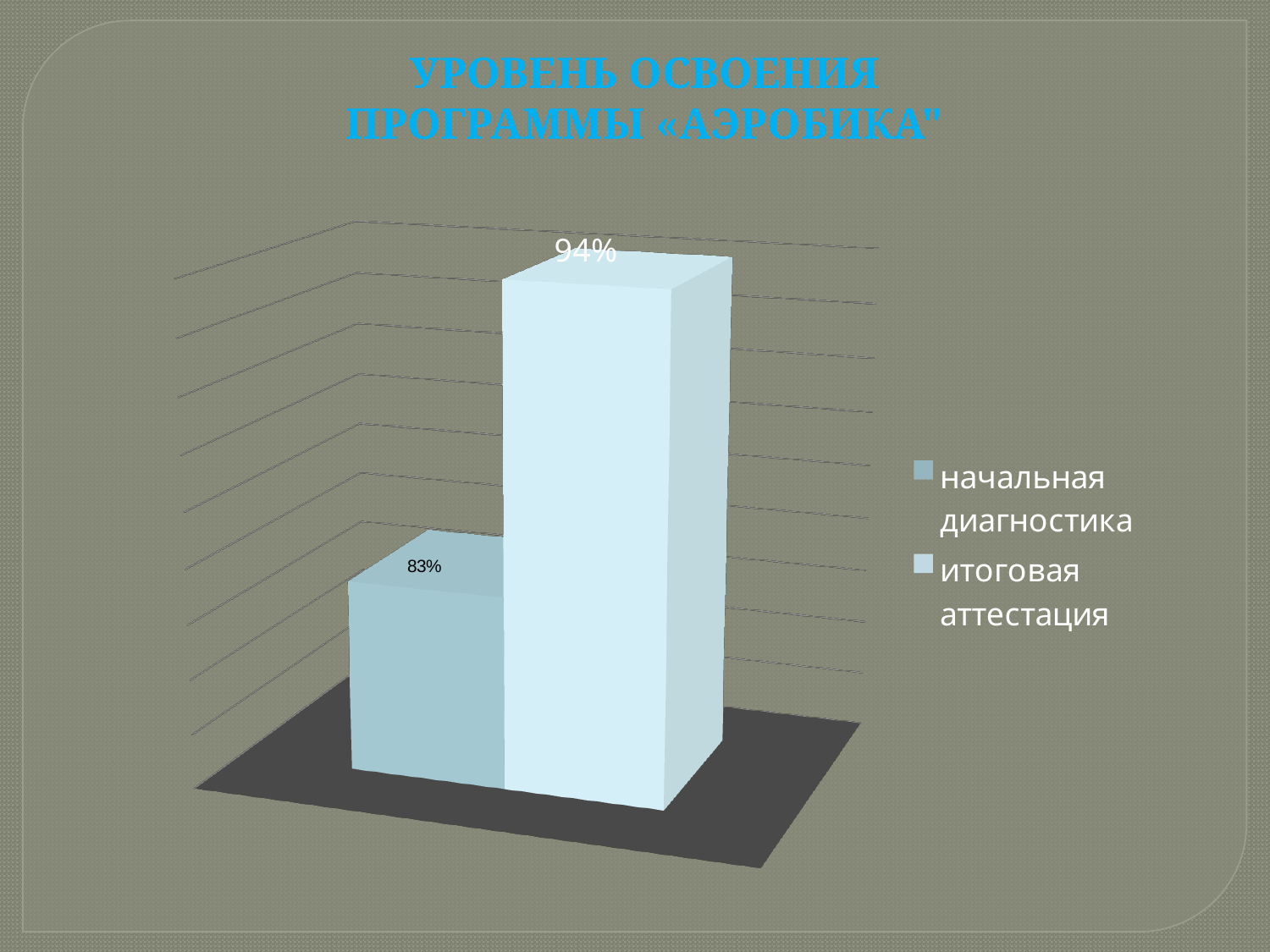
Which series has the lowest value? начальная диагностика What is the difference between the values for итоговая аттестация and начальная диагностика? 11% What kind of chart is shown on the slide? bar chart How many bars are plotted on the chart? 2 What are the two entries listed in the legend? начальная диагностика, итоговая аттестация What is the value for итоговая аттестация? 94% How many series does the legend list? 2 Which is larger, the value for начальная диагностика or the value for итоговая аттестация? итоговая аттестация What is the value for начальная диагностика? 83% What is the title of the chart? УРОВЕНЬ ОСВОЕНИЯ ПРОГРАММЫ «АЭРОБИКА" Which series has the highest value? итоговая аттестация